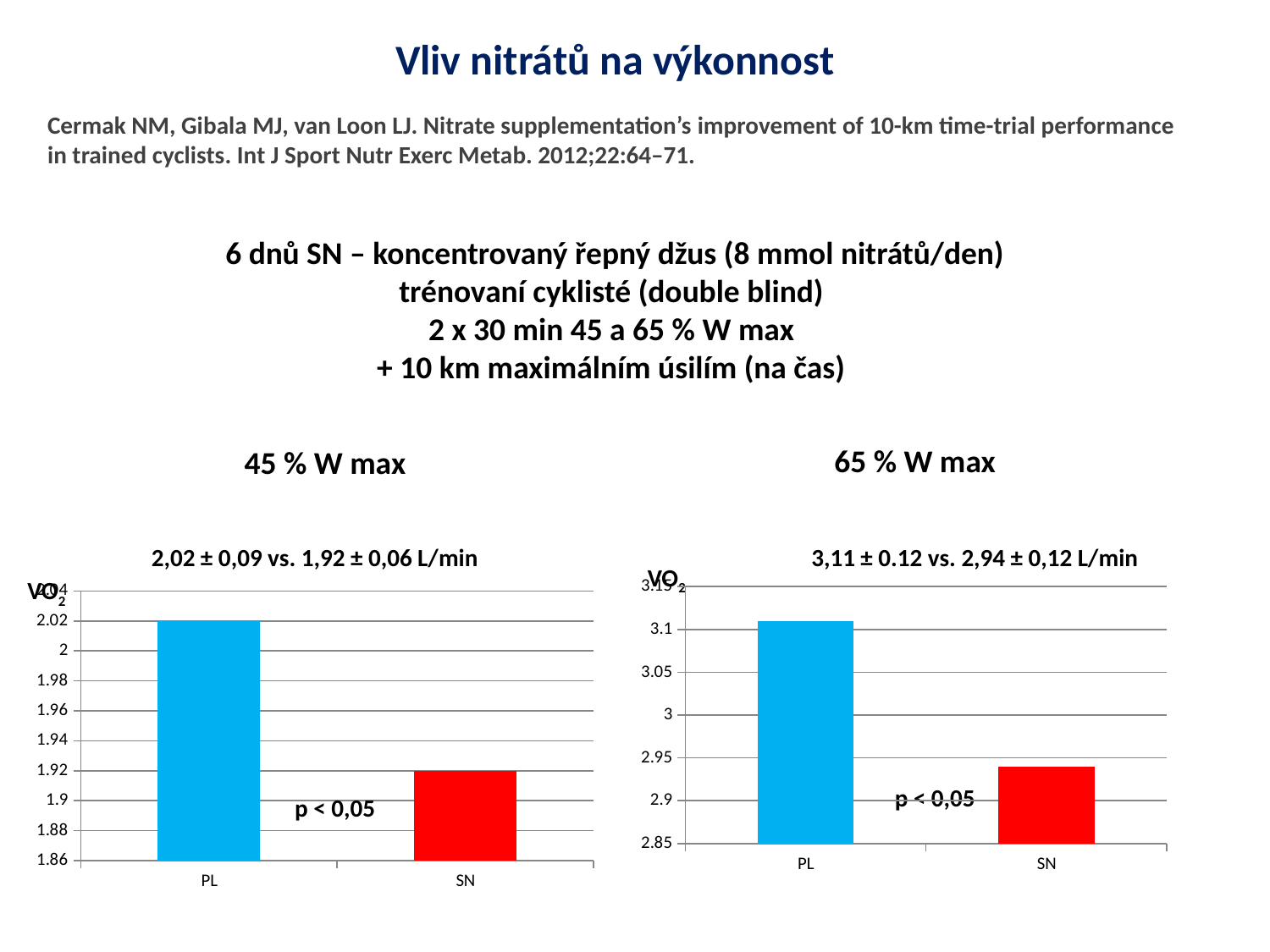
In the 45 % W max chart, what is the difference between the PL and SN values? 0.1 In the 65 % W max chart, which category has the lower value? SN In the 45 % W max chart, what colour is the SN bar? red What type of chart is the 65 % W max chart? bar chart In the 65 % W max chart, is the value for PL larger or smaller than the value for SN? larger How many categories are shown in the 45 % W max chart? 2 In the 65 % W max chart, is the value for SN greater or less than 3? less In the 45 % W max chart, which category has the higher value? PL What p-value annotation is shown on the 65 % W max chart? p < 0,05 In the 45 % W max chart, what is the value for SN? 1.92 In the 45 % W max chart, what is the value for PL? 2.02 In the 65 % W max chart, is the value for PL greater or less than 3.05? greater